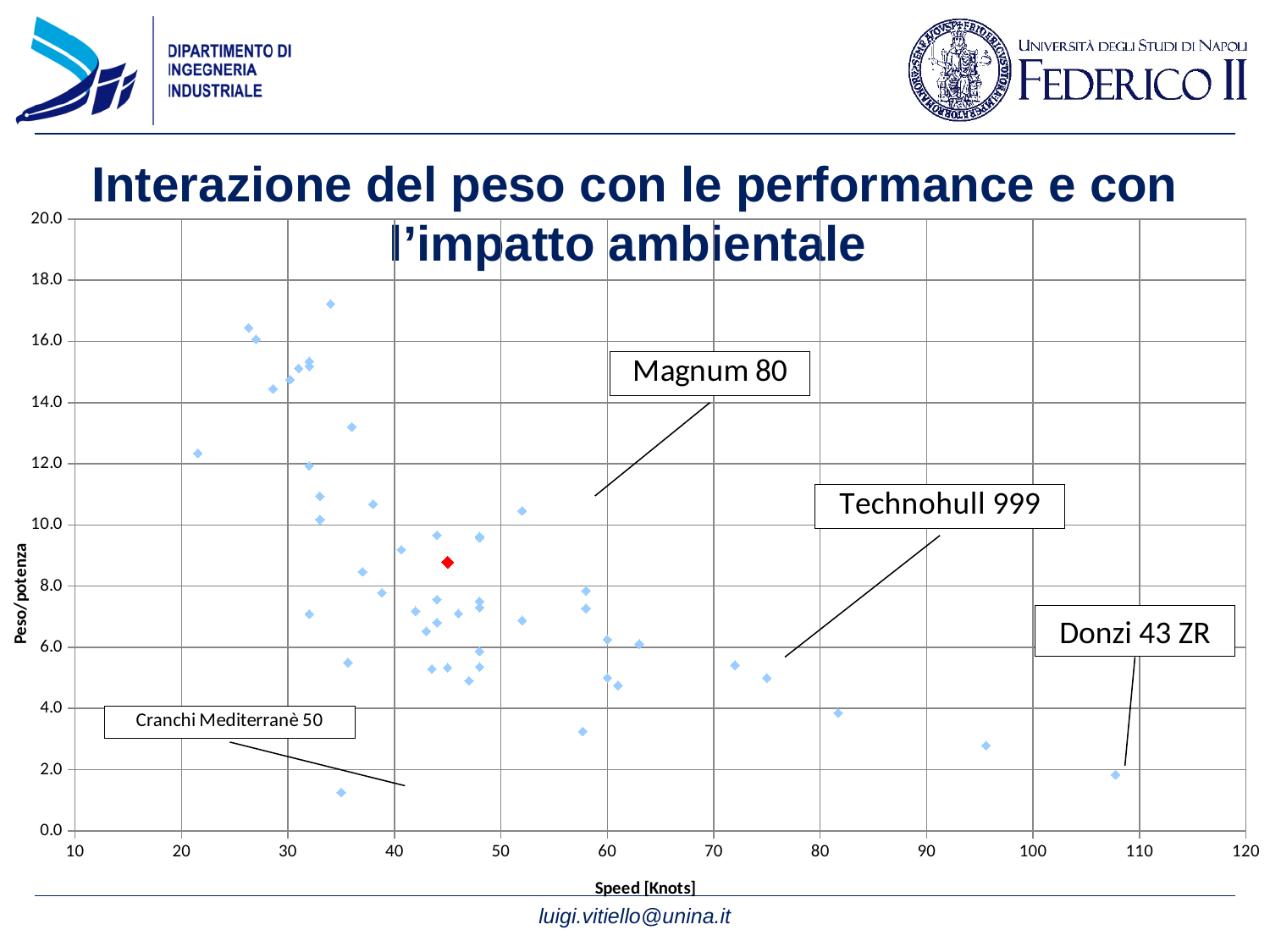
What kind of chart is shown on the slide? scatter chart Which of the labelled boats has the highest speed? Donzi 43 ZR How many boats are named with callout labels on the chart? 4 What is the title of the x axis of the chart? Speed [Knots] Is the speed of Donzi 43 ZR greater or less than 100 knots? greater Is the speed of Technohull 999 greater or less than 70 knots? greater Is the Peso/potenza value for Cranchi Mediterranè 50 greater or less than 4.0? less What is the title of the y axis of the chart? Peso/potenza Which has the higher speed, Magnum 80 or Technohull 999? Technohull 999 Which of the labelled boats has the highest Peso/potenza value? Magnum 80